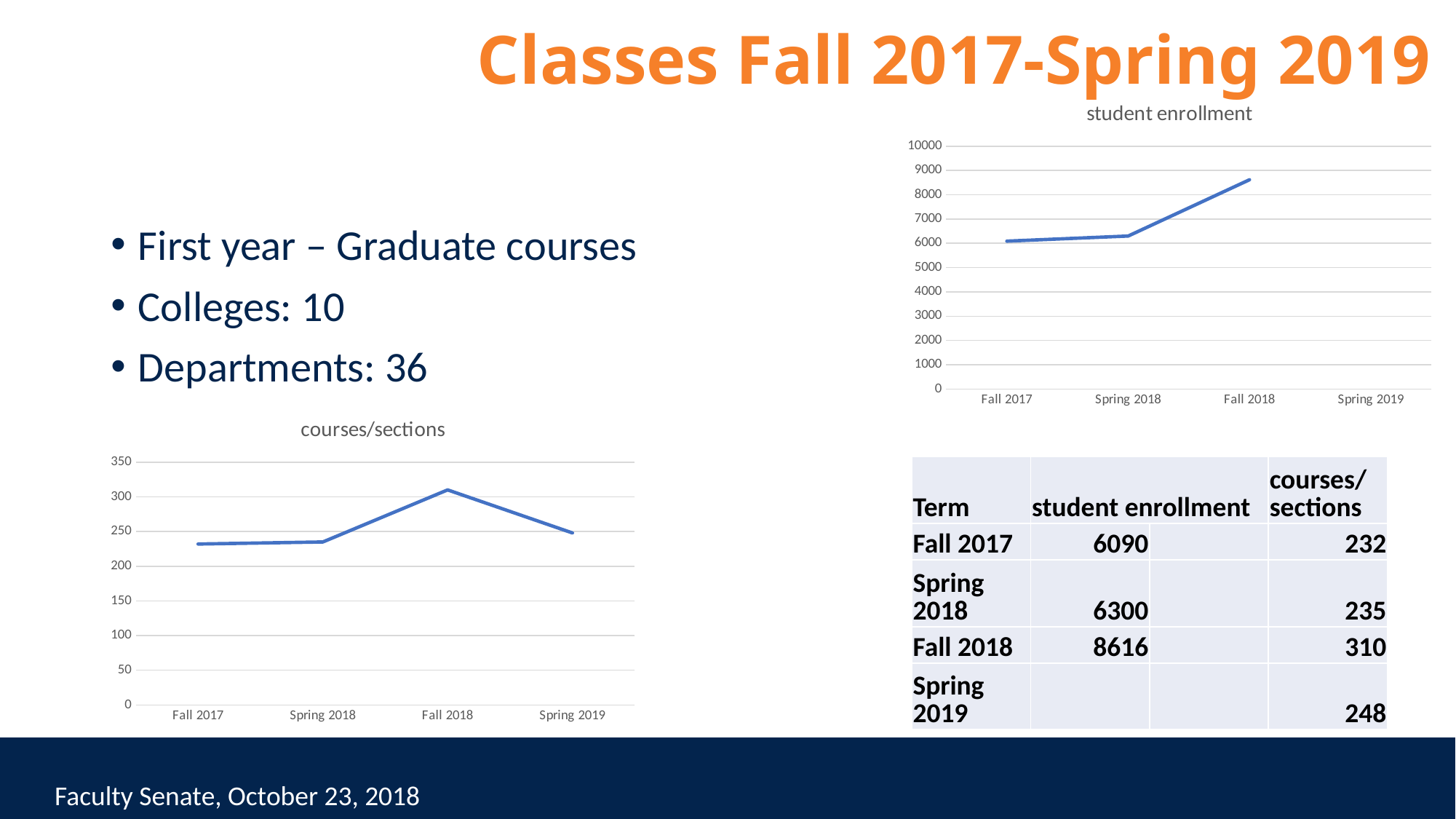
In the "courses/sections" chart, is the value for Fall 2018 greater or less than 300? greater What type of chart is the "courses/sections" chart? line chart In the "student enrollment" chart, is the value for Fall 2018 greater or less than 8000? greater What type of chart is the "student enrollment" chart? line chart In the "courses/sections" chart, how many terms are shown on the x axis? 4 In the "student enrollment" chart, is the value for Fall 2017 greater or less than 7000? less In the "courses/sections" chart, which term has the lowest value? Fall 2017 In the "courses/sections" chart, which term has the highest value? Fall 2018 In the "student enrollment" chart, does the line rise or fall from Fall 2017 to Fall 2018? rise In the "student enrollment" chart, how many terms have a plotted data point? 3 According to the table on the slide, what is the student enrollment for Fall 2018? 8616 In the "student enrollment" chart, which is larger, the value for Spring 2018 or Fall 2018? Fall 2018